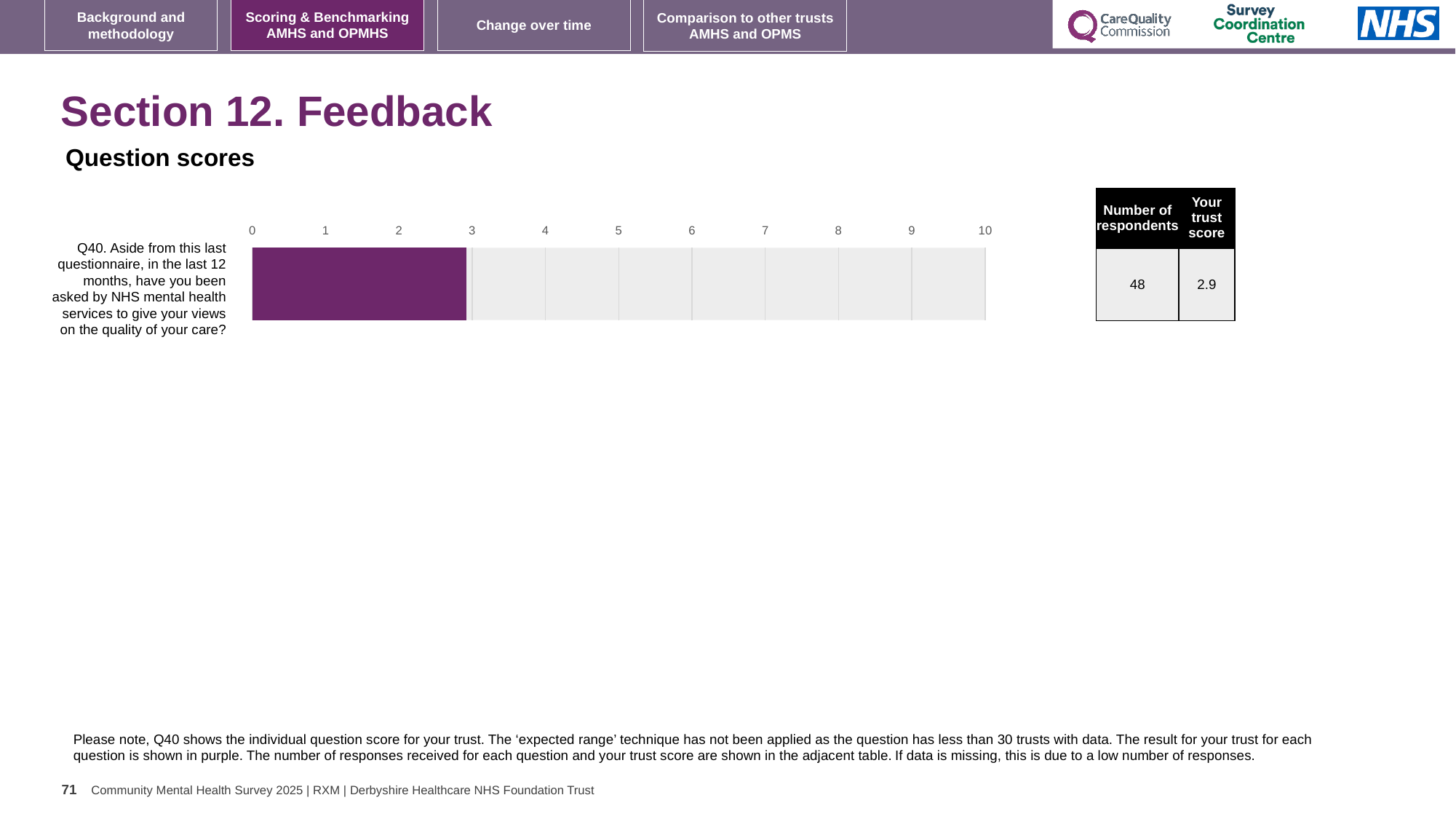
What is the trust score for Q40 shown in the adjacent table? 2.9 Is the value for Q40 greater or less than 5? less What colour is the bar representing the trust's score for Q40? purple What is the maximum value shown on the chart's axis? 10 How many respondents answered Q40 according to the table? 48 How many questions (categories) are plotted in the chart? 1 Is the value for Q40 greater or less than 2? greater What kind of chart is shown on the slide? bar chart